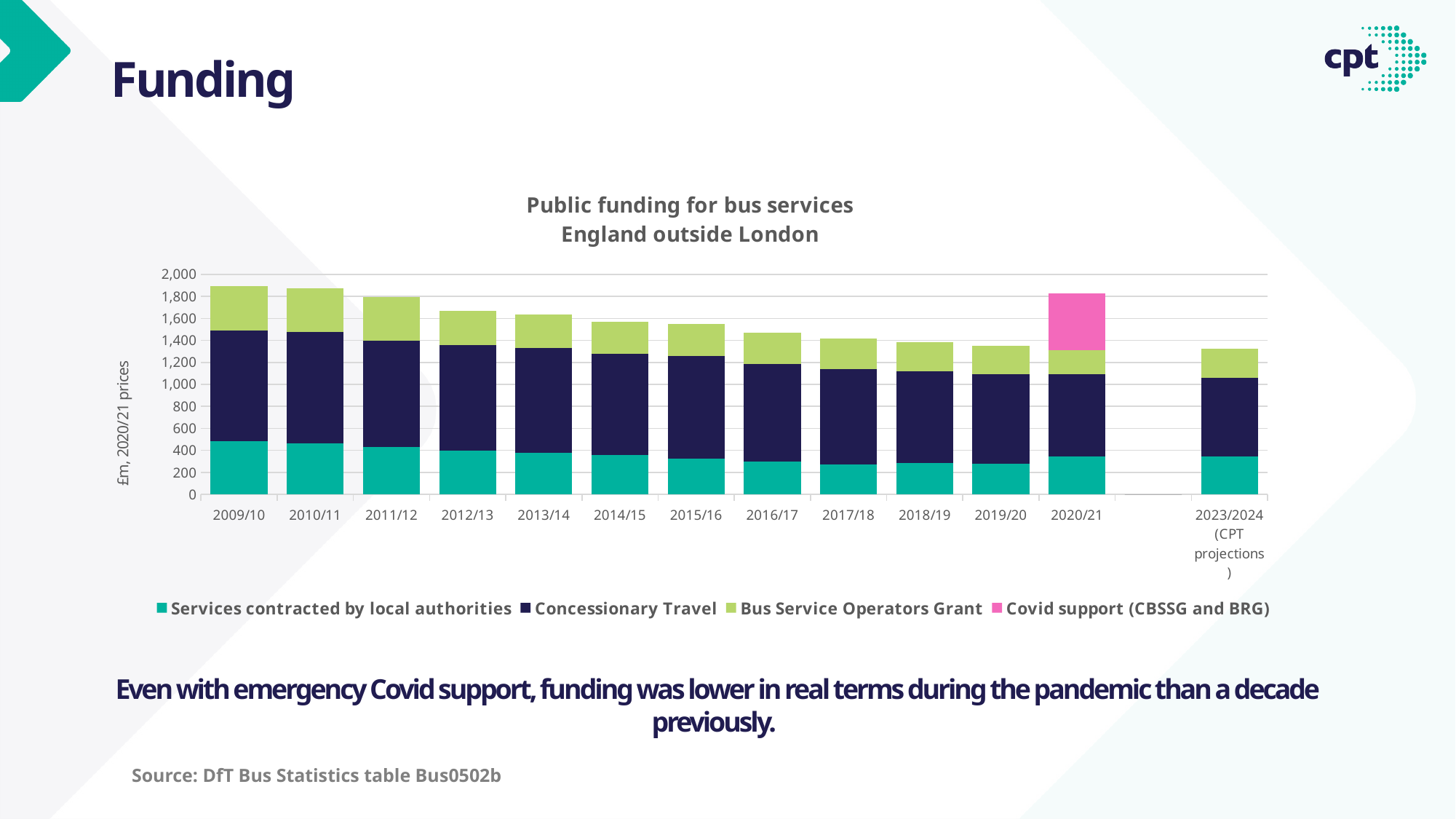
What kind of chart is shown on the slide? Stacked bar chart Which year has the larger total funding, 2009/10 or 2019/20? 2009/10 Is the total funding for 2023/2024 (CPT projections) greater or less than 1,400? less In which year does the Covid support (CBSSG and BRG) series appear? 2020/21 How many labelled year categories are shown on the x axis? 13 Is the total funding for 2020/21 greater or less than 1,600? greater Is the total funding for 2019/20 greater or less than 1,400? less How many series does the legend list? 4 Do total funding values rise or fall from 2009/10 to 2019/20? Fall What is the label on the y axis? £m, 2020/21 prices What is the title of the chart? Public funding for bus services England outside London